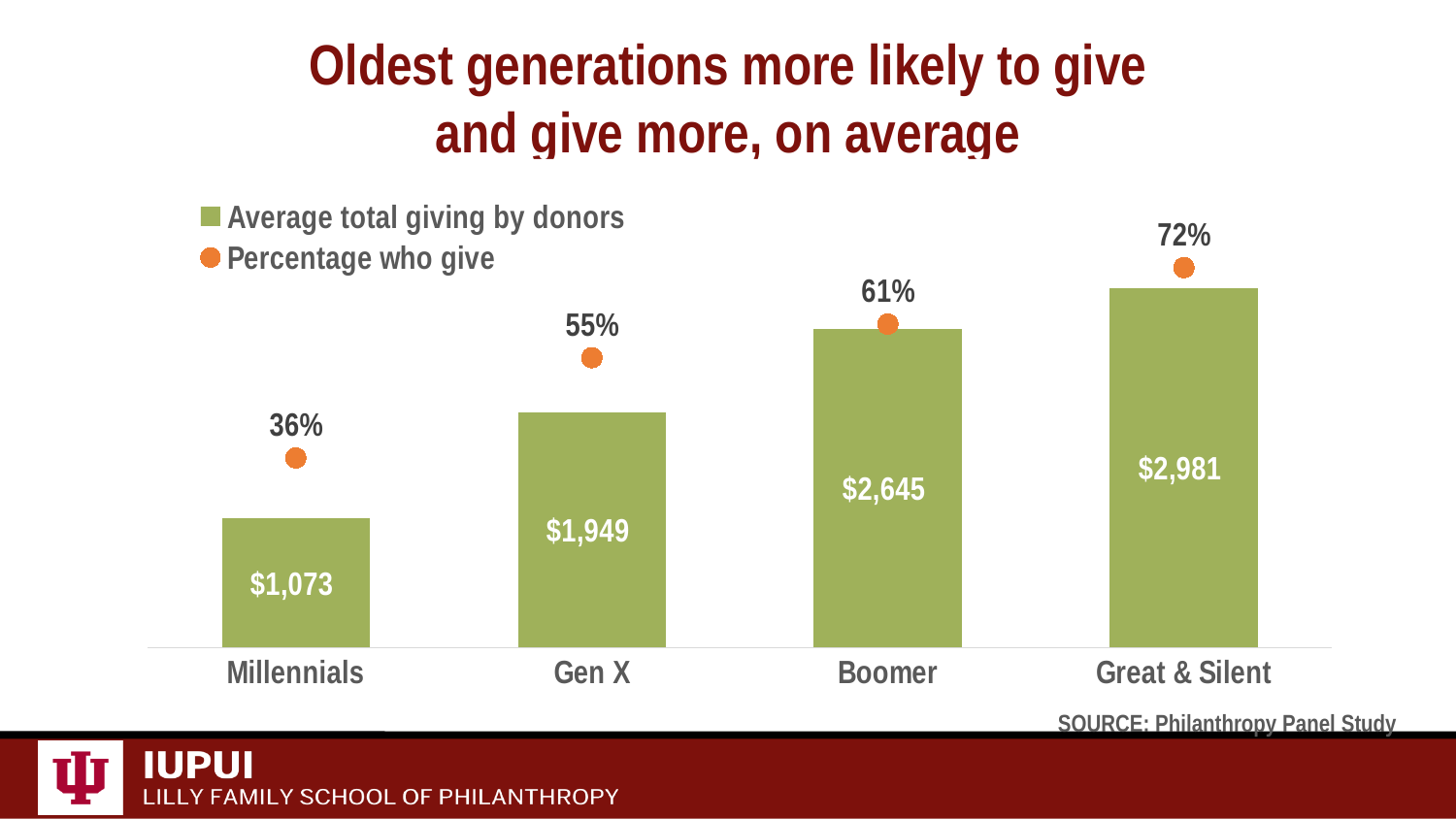
What is the difference in average total giving by donors between Boomer and Gen X? $696 How many series does the legend list? 2 Which generation has the lowest percentage who give? Millennials How many generations are shown on the x axis? 4 Which generation has the highest average total giving by donors? Great & Silent Which has a higher average total giving by donors, Gen X or Boomer? Boomer What is the average total giving by donors for Great & Silent? $2,981 What is the average total giving by donors for Millennials? $1,073 What percentage of Gen X give? 55% What percentage of Boomers give? 61% Do the average total giving values rise or fall from Millennials to Great & Silent? rise What is the difference in percentage who give between Great & Silent and Millennials? 36%